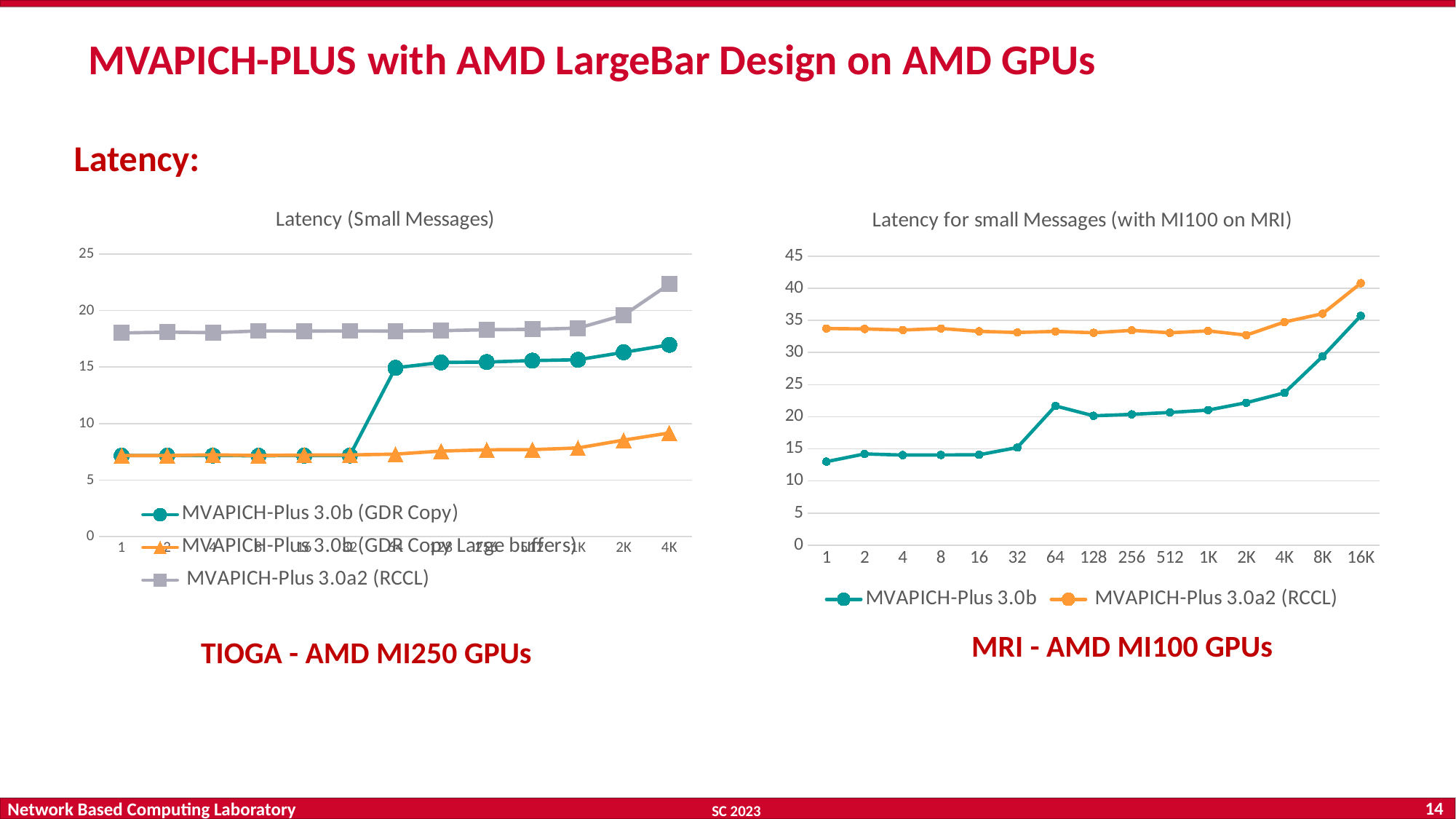
In the right chart 'Latency for small Messages (with MI100 on MRI)', which series has the larger value at message size 64? MVAPICH-Plus 3.0a2 (RCCL) In the right chart 'Latency for small Messages (with MI100 on MRI)', at which message size does MVAPICH-Plus 3.0b reach its highest value? 16K How many series does the legend of the right chart 'Latency for small Messages (with MI100 on MRI)' list? 2 What kind of chart is the left chart titled 'Latency (Small Messages)'? line chart How many series does the legend of the left chart 'Latency (Small Messages)' list? 3 In the right chart 'Latency for small Messages (with MI100 on MRI)', is the value for MVAPICH-Plus 3.0a2 (RCCL) at message size 1 greater or less than 30? greater In the left chart 'Latency (Small Messages)', is the value for MVAPICH-Plus 3.0b (GDR Copy Large buffers) at 4K greater or less than 10? less In the left chart 'Latency (Small Messages)', is the value for MVAPICH-Plus 3.0a2 (RCCL) at message size 1 greater or less than 15? greater In the left chart 'Latency (Small Messages)', does the MVAPICH-Plus 3.0b (GDR Copy) series rise or fall overall from left to right? rise How many message-size categories are on the x axis of the right chart 'Latency for small Messages (with MI100 on MRI)'? 15 In the left chart 'Latency (Small Messages)', which series has the highest value at 4K? MVAPICH-Plus 3.0a2 (RCCL)